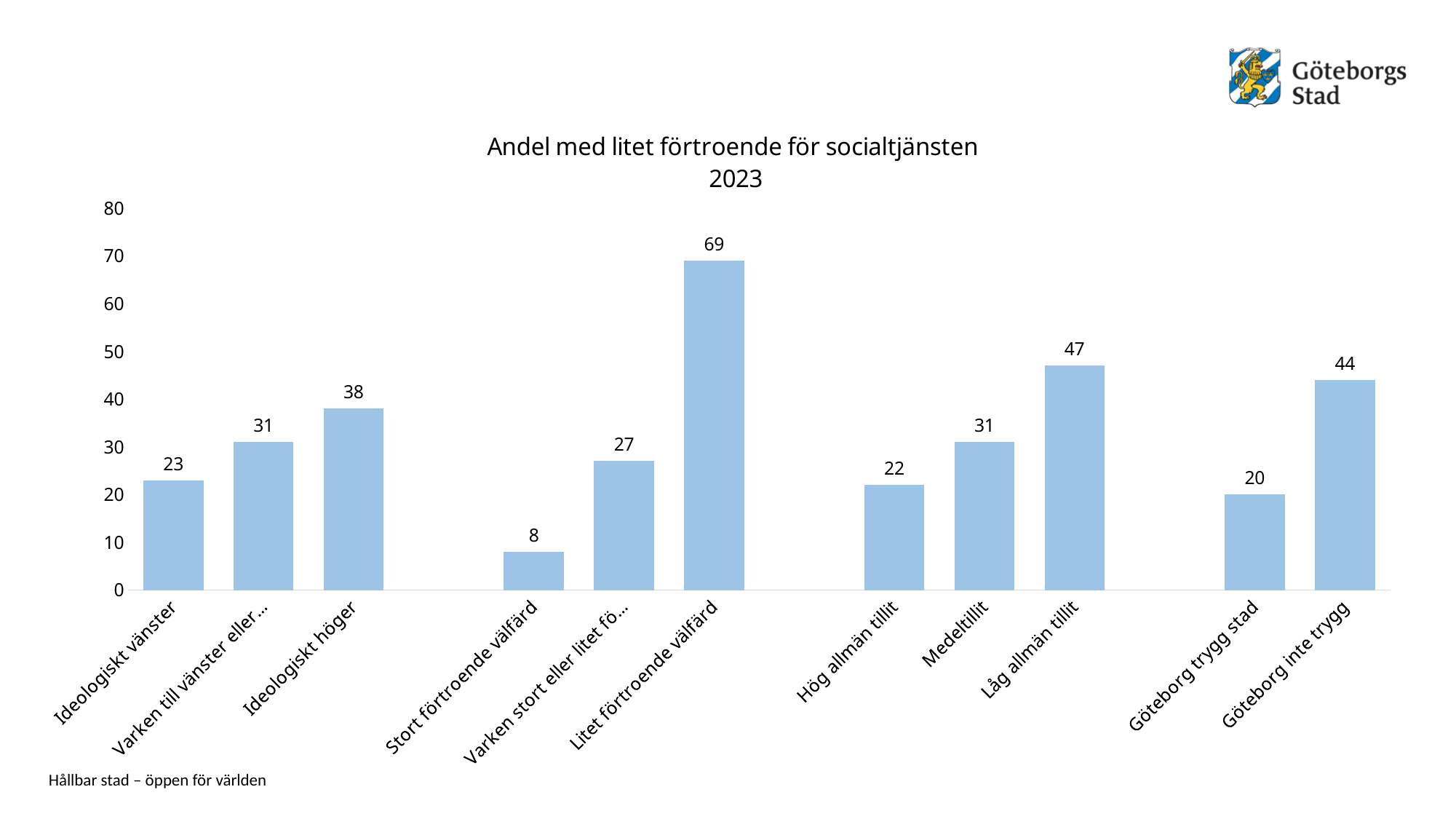
Which is larger, Göteborg inte trygg or Ideologiskt höger? Göteborg inte trygg What is the value for Ideologiskt vänster? 23 Which category has the lowest value? Stort förtroende välfärd Which category has the highest value? Litet förtroende välfärd Is the value for Medeltillit greater or less than 40? less What is the value for Litet förtroende välfärd? 69 What kind of chart is shown on the slide? Bar chart What is the title of the chart? Andel med litet förtroende för socialtjänsten 2023 What is the value for Stort förtroende välfärd? 8 What is the difference between Ideologiskt höger and Ideologiskt vänster? 15 What is the difference between Låg allmän tillit and Hög allmän tillit? 25 What is the value for Göteborg inte trygg? 44